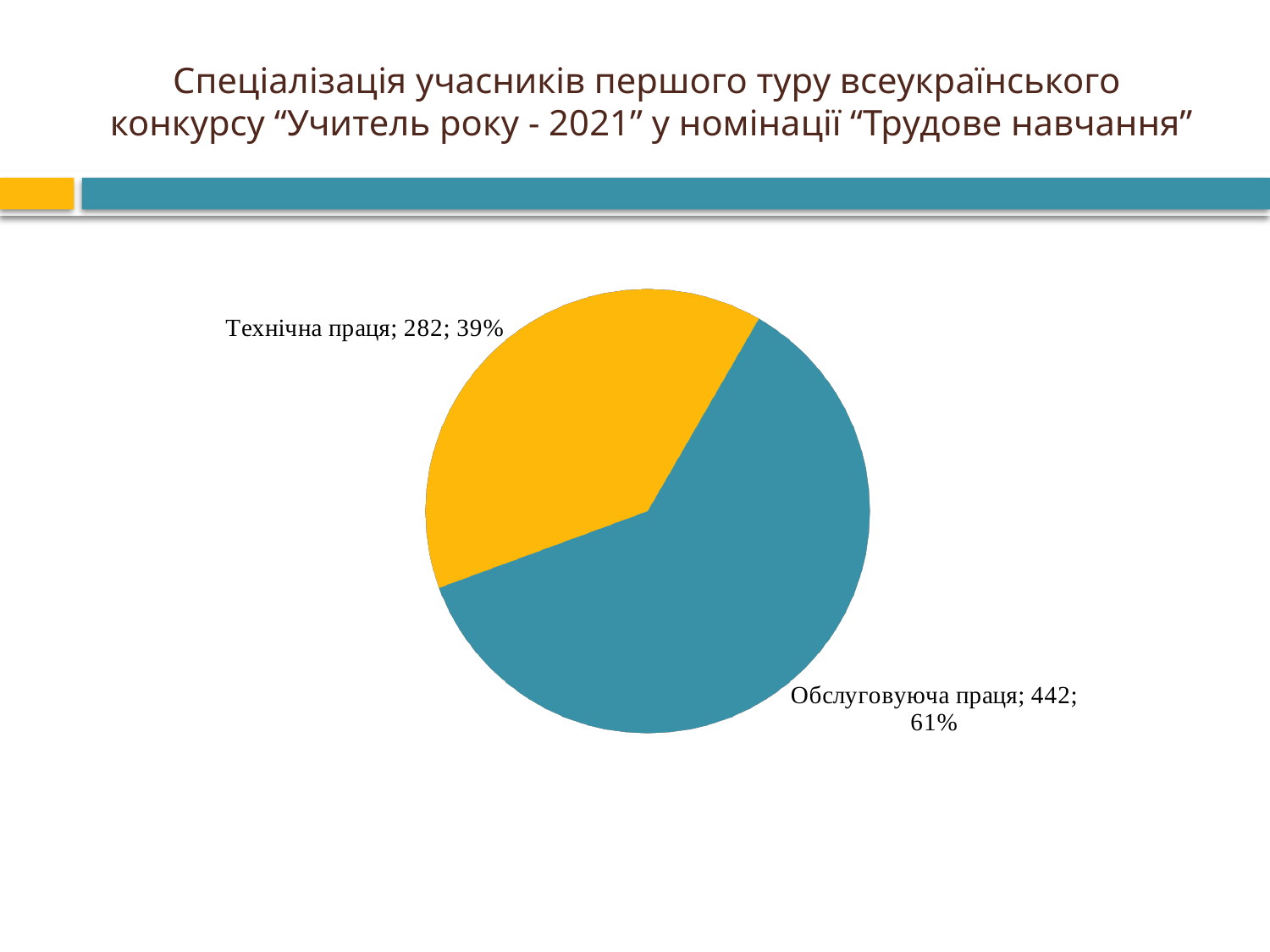
What share of the pie does Обслуговуюча праця represent? 61% Which is larger, the value for Технічна праця or the value for Обслуговуюча праця? Обслуговуюча праця What kind of chart is shown on the slide? pie chart What colour is the slice for Технічна праця? yellow What is the value for Обслуговуюча праця? 442 How many slices does the pie chart have? 2 What is the total of the two values shown in the pie chart? 724 What share of the pie does Технічна праця represent? 39% What is the value for Технічна праця? 282 Which category has the smallest slice? Технічна праця What is the difference between the values for Обслуговуюча праця and Технічна праця? 160 Which category has the largest slice? Обслуговуюча праця